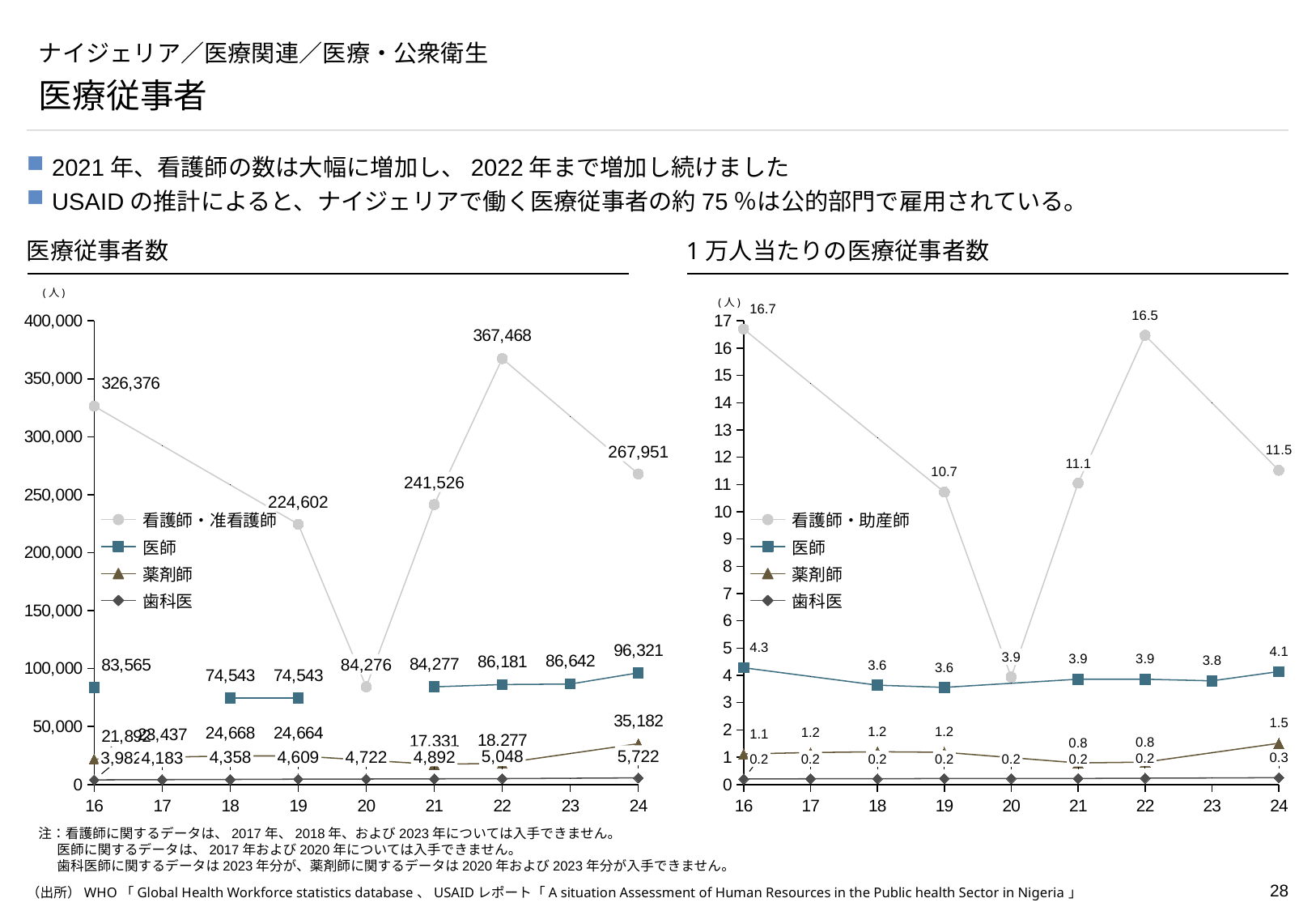
In the left chart (医療従事者数), what is the value for 医師 in 24? 96,321 In the right chart (1万人当たりの医療従事者数), what is the value for 医師 in 24? 4.1 In the left chart (医療従事者数), how many series does the legend list? 4 What kind of chart is the left chart (医療従事者数)? line chart In the left chart (医療従事者数), what is the value for 看護師・准看護師 in 22? 367,468 In the right chart (1万人当たりの医療従事者数), what is the value for 看護師・助産師 in 16? 16.7 In the left chart (医療従事者数), in which year is the 看護師・准看護師 value lowest? 20 In the right chart (1万人当たりの医療従事者数), in which year is the 看護師・助産師 value lowest? 20 In the right chart (1万人当たりの医療従事者数), which is larger, the 薬剤師 value in 24 or the 薬剤師 value in 21? 24 In the left chart (医療従事者数), does the 歯科医 value rise or fall from 16 to 24? rise In the left chart (医療従事者数), what is the difference between the 看護師・准看護師 values in 22 and 24? 99,517 In the left chart (医療従事者数), what is the value for 薬剤師 in 24? 35,182